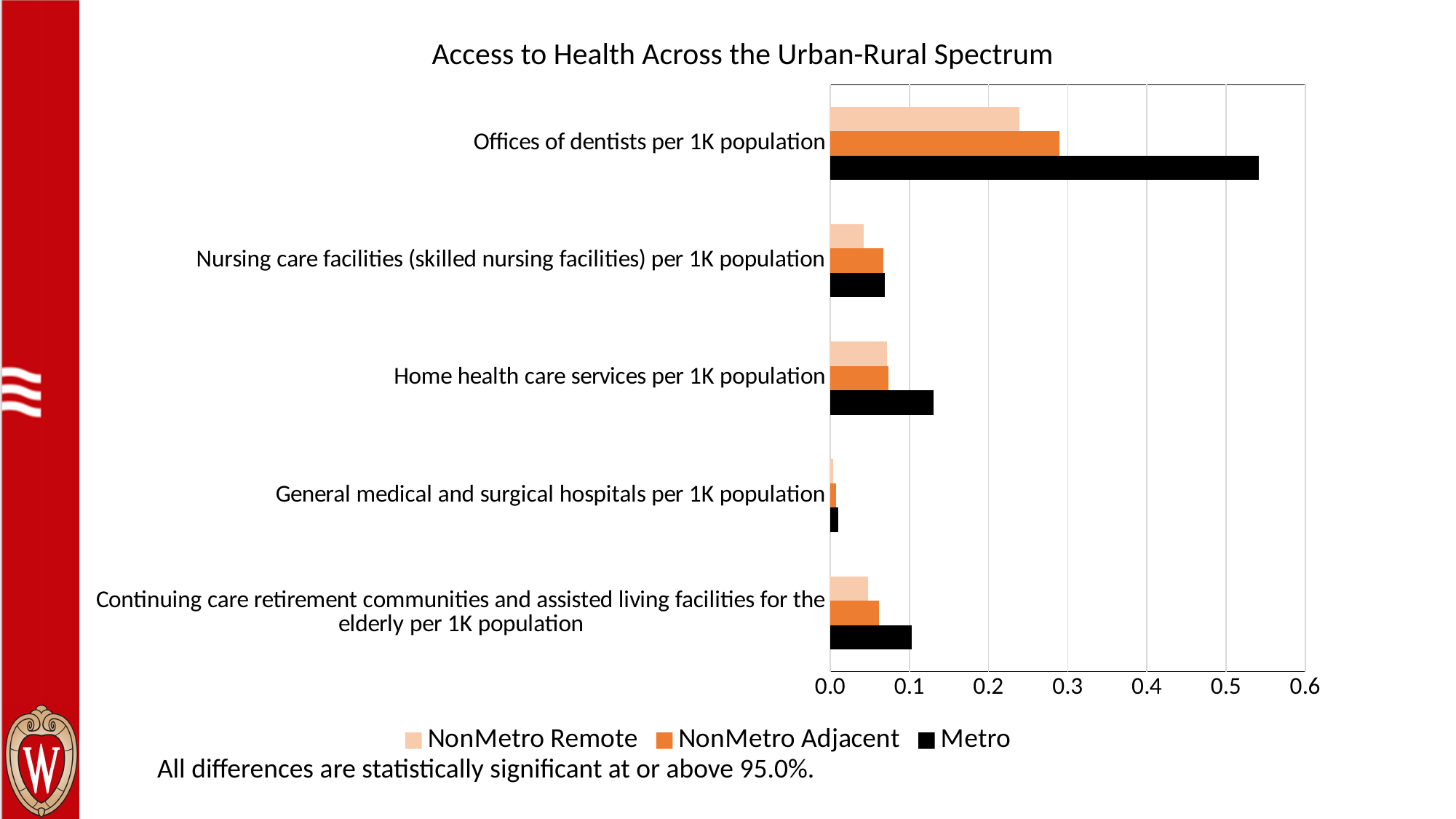
What type of chart is shown on the slide? Bar chart For Offices of dentists per 1K population, which series has the highest value? Metro Is the NonMetro Remote value for Offices of dentists per 1K population greater or less than 0.2? greater For Home health care services per 1K population, which is larger: the Metro value or the NonMetro Remote value? Metro What is the title of the chart? Access to Health Across the Urban-Rural Spectrum Which category has the highest Metro value? Offices of dentists per 1K population Is the Metro value for Offices of dentists per 1K population greater or less than 0.5? greater How many series does the legend list? 3 Is the Metro value for Home health care services per 1K population greater or less than 0.1? greater How many categories are plotted on the chart? 5 Which category has the lowest Metro value? General medical and surgical hospitals per 1K population Which series is shown in black? Metro